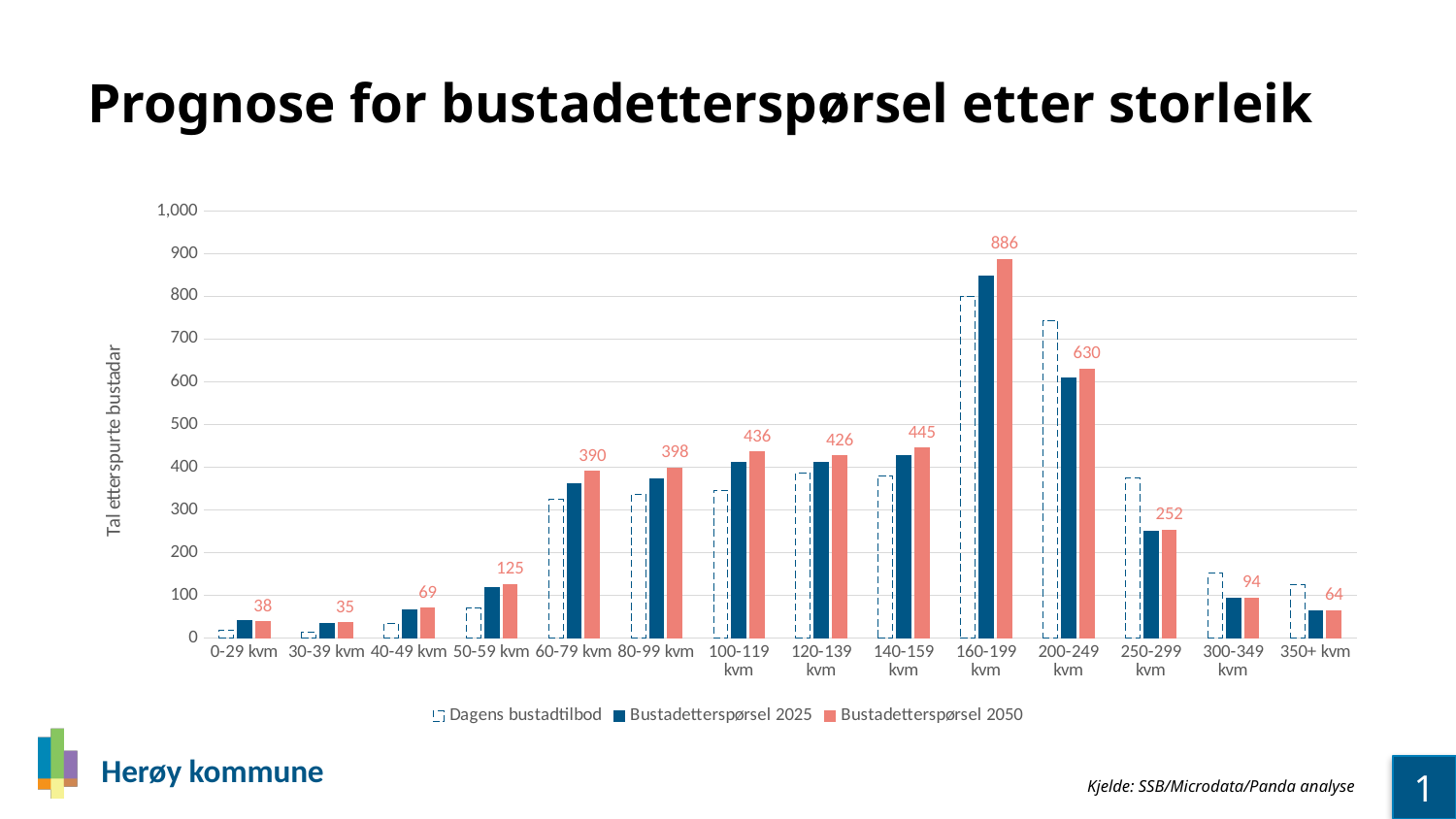
What is the difference between the Bustadetterspørsel 2050 values for 160-199 kvm and 200-249 kvm? 256 Which category has the highest value for Bustadetterspørsel 2050? 160-199 kvm How many series does the legend list? 3 How many size categories are shown on the x axis? 14 Which category has the lowest value for Bustadetterspørsel 2050? 30-39 kvm Is the value for Bustadetterspørsel 2025 in the 250-299 kvm category greater or less than 300? less What is the value for Bustadetterspørsel 2050 in the 50-59 kvm category? 125 What kind of chart is shown on the slide? Bar chart What is the value for Bustadetterspørsel 2050 in the 250-299 kvm category? 252 Is the value for Dagens bustadtilbod in the 200-249 kvm category greater or less than 700? greater What is the value for Bustadetterspørsel 2050 in the 160-199 kvm category? 886 Which is larger for Bustadetterspørsel 2050: 100-119 kvm or 120-139 kvm? 100-119 kvm